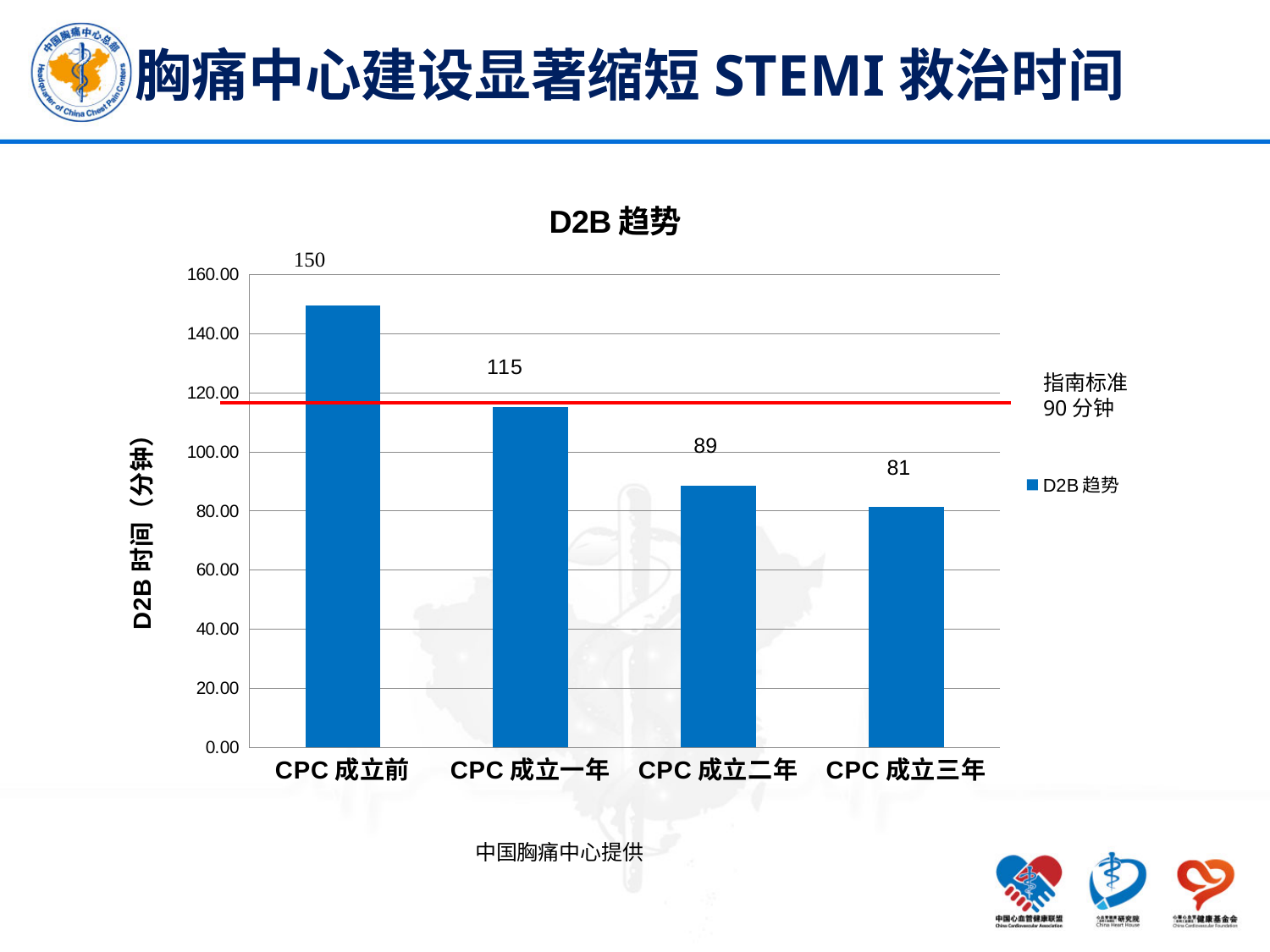
What is the D2B time for CPC 成立三年? 81 Do the D2B values rise or fall from CPC 成立前 to CPC 成立三年? Fall What is the D2B time for CPC 成立一年? 115 What is the title of the chart? D2B 趋势 Which is larger, the D2B time for CPC 成立一年 or CPC 成立二年? CPC 成立一年 What is the D2B time for CPC 成立二年? 89 What kind of chart is shown on the slide? Bar chart How many categories are shown on the x axis? 4 What is the difference in D2B time between CPC 成立前 and CPC 成立三年? 69 Which category has the highest D2B time? CPC 成立前 Which category has the lowest D2B time? CPC 成立三年 What is the D2B time for CPC 成立前? 150